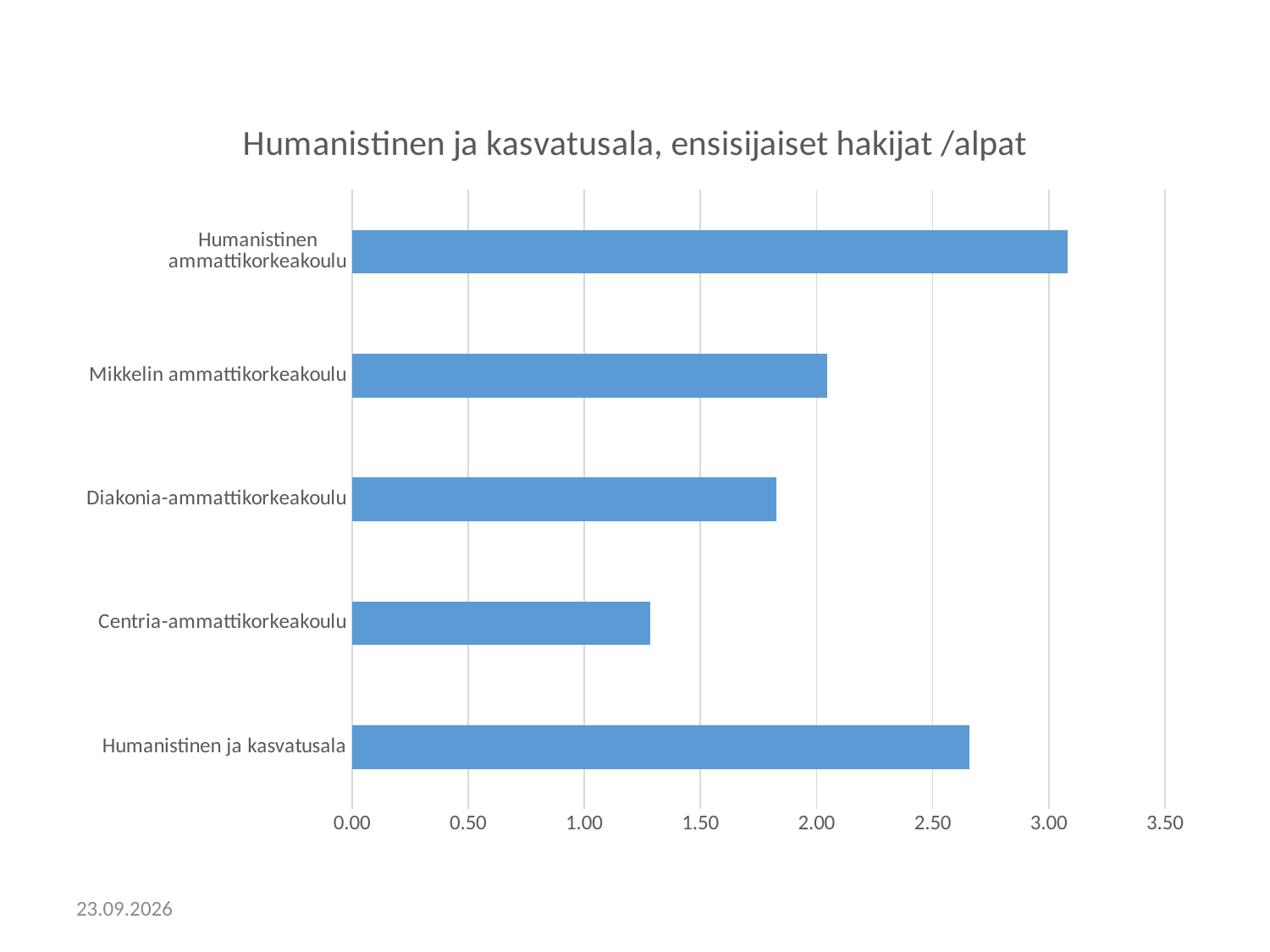
What is the title of the chart? Humanistinen ja kasvatusala, ensisijaiset hakijat /alpat Is the value for Centria-ammattikorkeakoulu greater or less than 1.50? less Is the value for Mikkelin ammattikorkeakoulu greater or less than 2.50? less Is the value for Humanistinen ja kasvatusala greater or less than 2.50? greater What kind of chart is shown on the slide? bar chart How many categories are plotted in the chart? 5 Which category has the highest value? Humanistinen ammattikorkeakoulu Which is larger, the value for Mikkelin ammattikorkeakoulu or the value for Diakonia-ammattikorkeakoulu? Mikkelin ammattikorkeakoulu Which category has the lowest value? Centria-ammattikorkeakoulu Which is larger, the value for Humanistinen ja kasvatusala or the value for Centria-ammattikorkeakoulu? Humanistinen ja kasvatusala